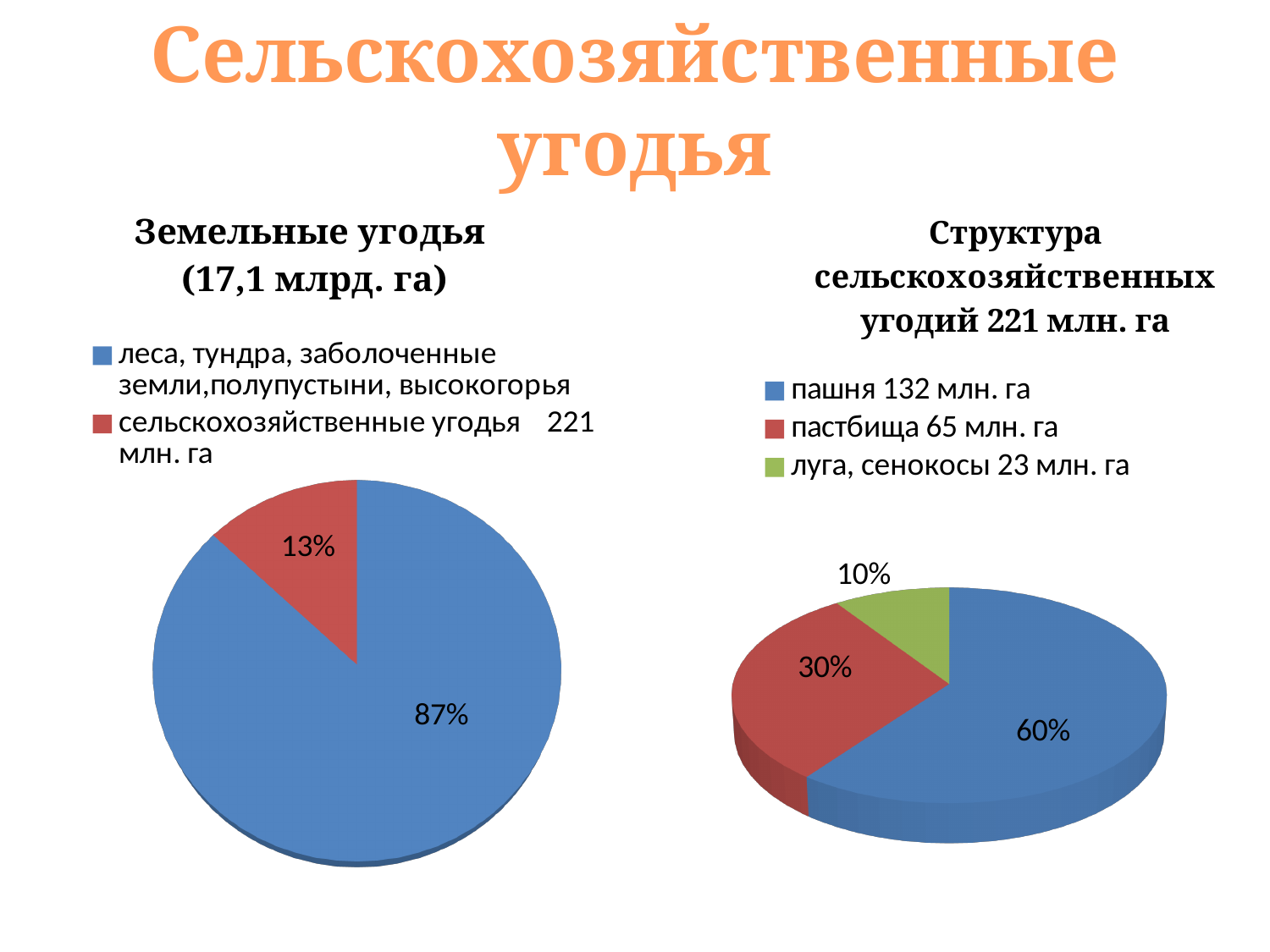
In the chart titled «Земельные угодья (17,1 млрд. га)», what share of the pie is labelled for «леса, тундра, заболоченные земли, полупустыни, высокогорья»? 87% In the chart on the right, what is the difference in percentage points between the «пашня» slice and the «пастбища» slice? 30 In the chart on the right, which category has the smallest slice? луга, сенокосы What type of chart is shown on the left side of the slide? Pie chart In the chart titled «Структура сельскохозяйственных угодий 221 млн. га», what share of the pie is labelled for «луга, сенокосы»? 10% In the chart titled «Структура сельскохозяйственных угодий 221 млн. га», what share of the pie is labelled for «пастбища»? 30% In the chart on the left, how many entries does the legend list? 2 In the chart on the right, what colour is the «луга, сенокосы» slice? Green In the chart on the right, how many slices does the pie have? 3 In the chart on the right, which category has the largest slice? пашня